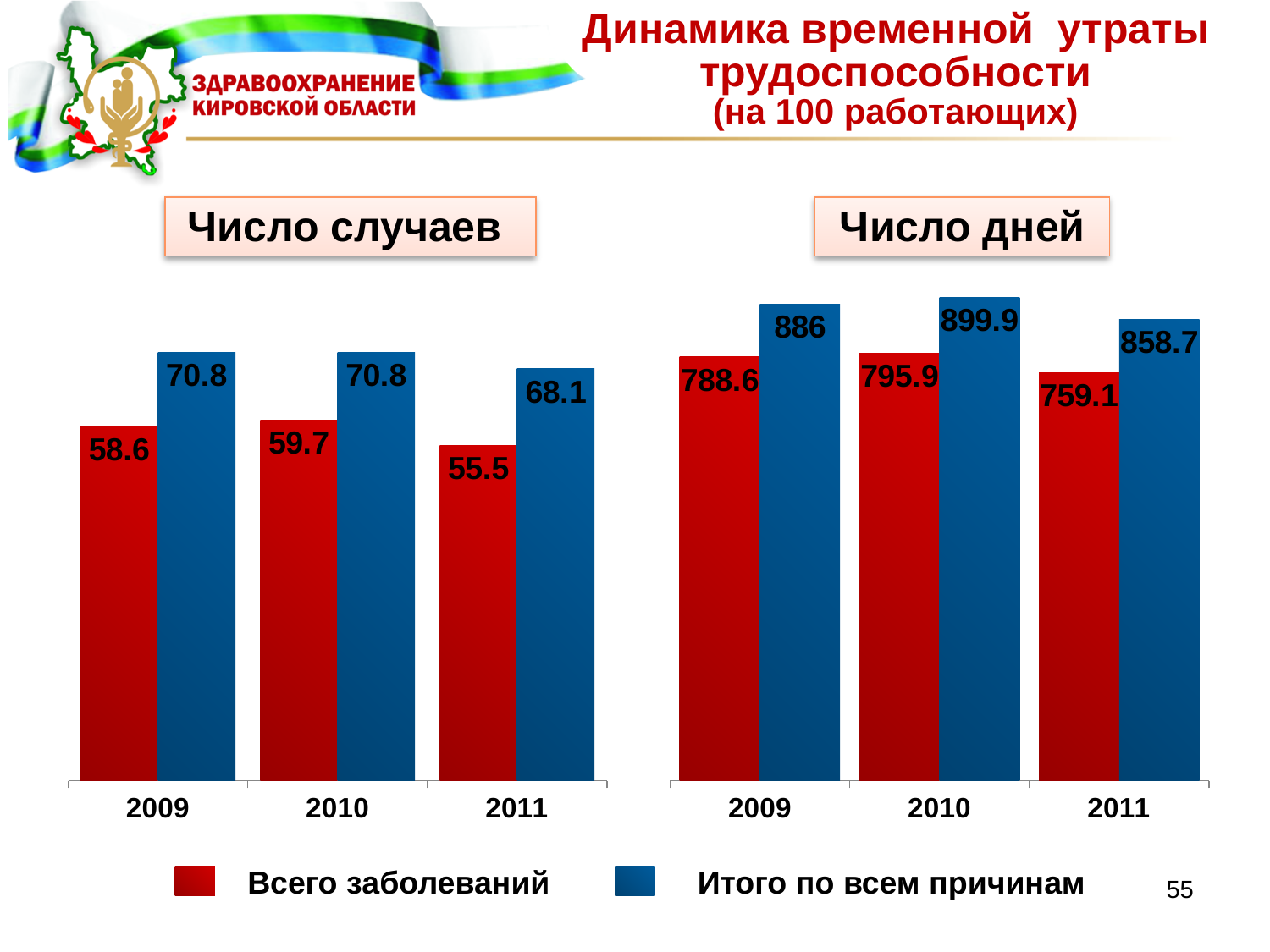
In the "Число дней" chart, which year has the highest value for "Итого по всем причинам"? 2010 What kind of chart is the "Число дней" chart? Bar chart How many years are shown on the x axis of the "Число случаев" chart? 3 In the "Число дней" chart, what is the difference between the "Всего заболеваний" values for 2010 and 2011? 36.8 In the "Число дней" chart, which is larger: "Итого по всем причинам" in 2011 or "Итого по всем причинам" in 2009? 2009 In the "Число дней" chart, what is the value for "Итого по всем причинам" in 2009? 886 How many series does the legend list? 2 In the "Число случаев" chart, which year has the lowest value for "Всего заболеваний"? 2011 In the "Число случаев" chart, what is the difference between "Итого по всем причинам" and "Всего заболеваний" in 2011? 12.6 In the "Число случаев" chart, what is the value for "Итого по всем причинам" in 2011? 68.1 In the "Число дней" chart, what is the value for "Всего заболеваний" in 2010? 795.9 In the "Число случаев" chart, what is the value for "Всего заболеваний" in 2009? 58.6